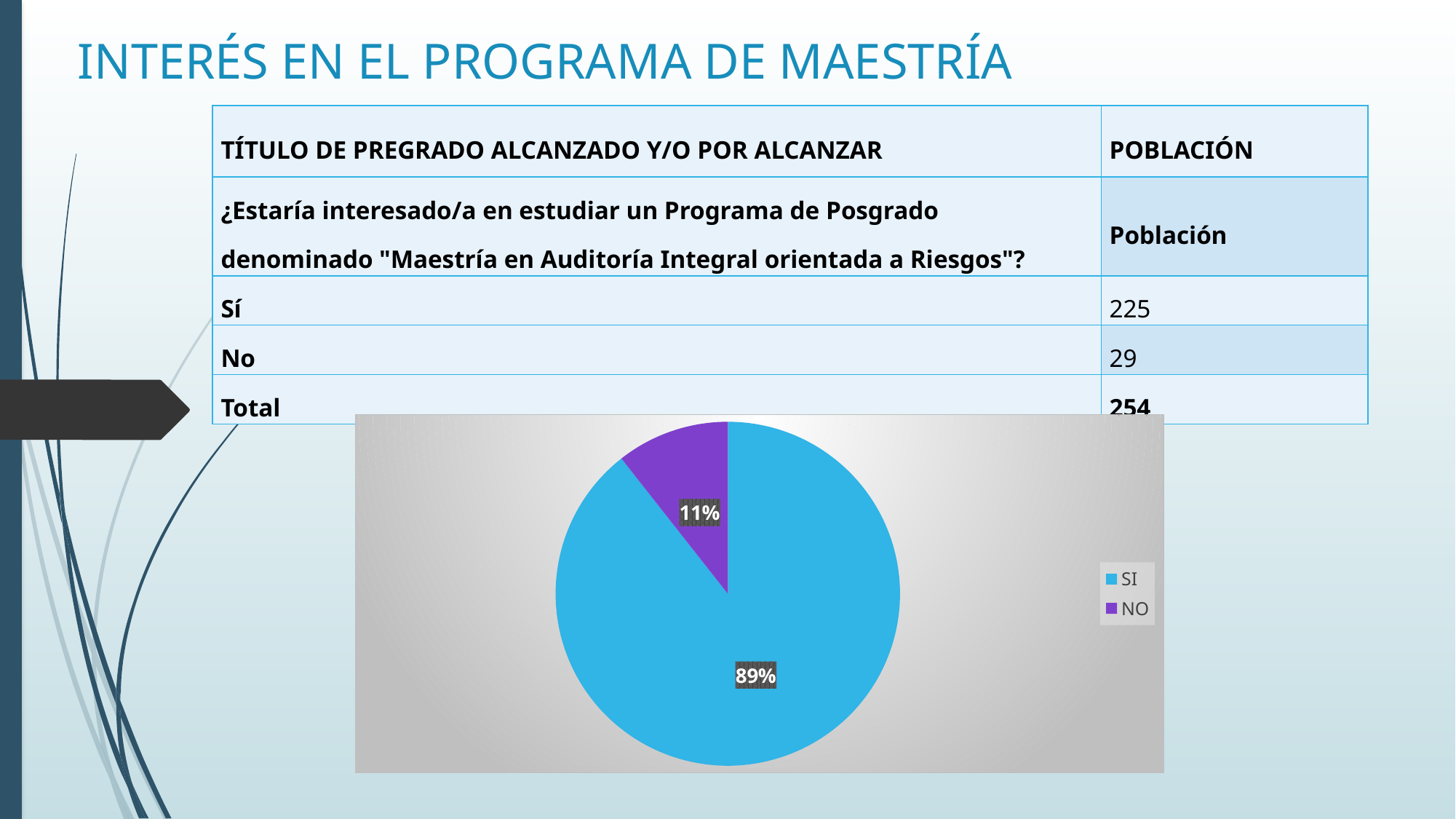
What is the difference in percentage points between the SI and NO slices? 78 What share of the pie does the SI slice represent? 89% Which is larger in the pie chart, SI or NO? SI How many slices does the pie chart have? 2 What colour is the SI slice in the pie chart? blue Which slice of the pie is the largest? SI What kind of chart is shown on the slide? pie chart What share of the pie does the NO slice represent? 11% Which slice of the pie is the smallest? NO What colour is the NO slice in the pie chart? purple How many entries does the legend list? 2